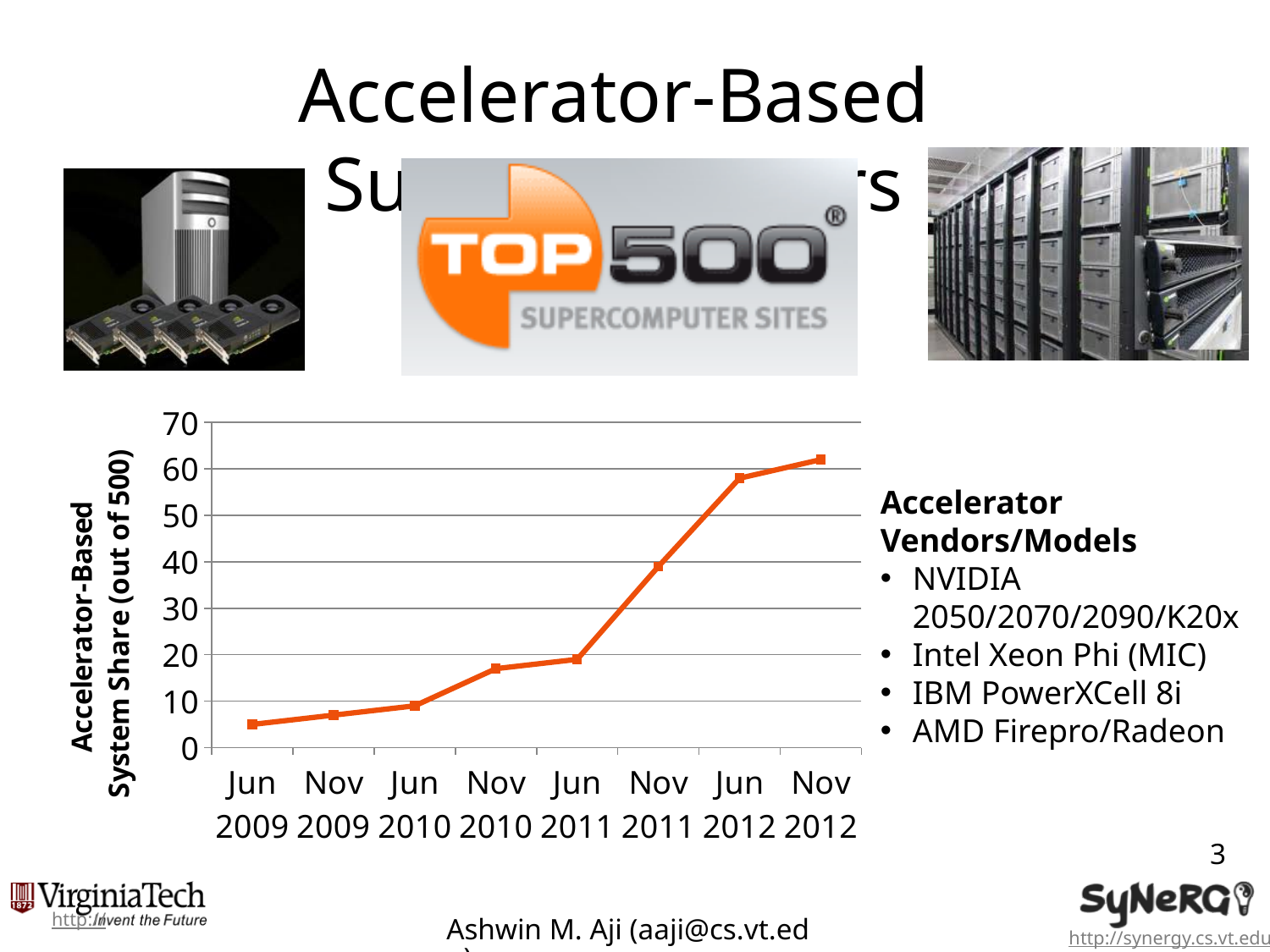
What kind of chart is shown on the slide? line chart Is the value for Nov 2012 greater or less than 60? greater Is the value for Nov 2011 greater or less than 30? greater What colour is the plotted line? orange What is the label of the y axis? Accelerator-Based System Share (out of 500) Do the values rise or fall from Jun 2009 to Nov 2012? rise Which is larger, the value for Jun 2012 or the value for Nov 2011? Jun 2012 How many data points are plotted on the line chart? 8 Which date has the lowest accelerator-based system share? Jun 2009 Which date has the highest accelerator-based system share? Nov 2012 Is the value for Jun 2009 greater or less than 10? less